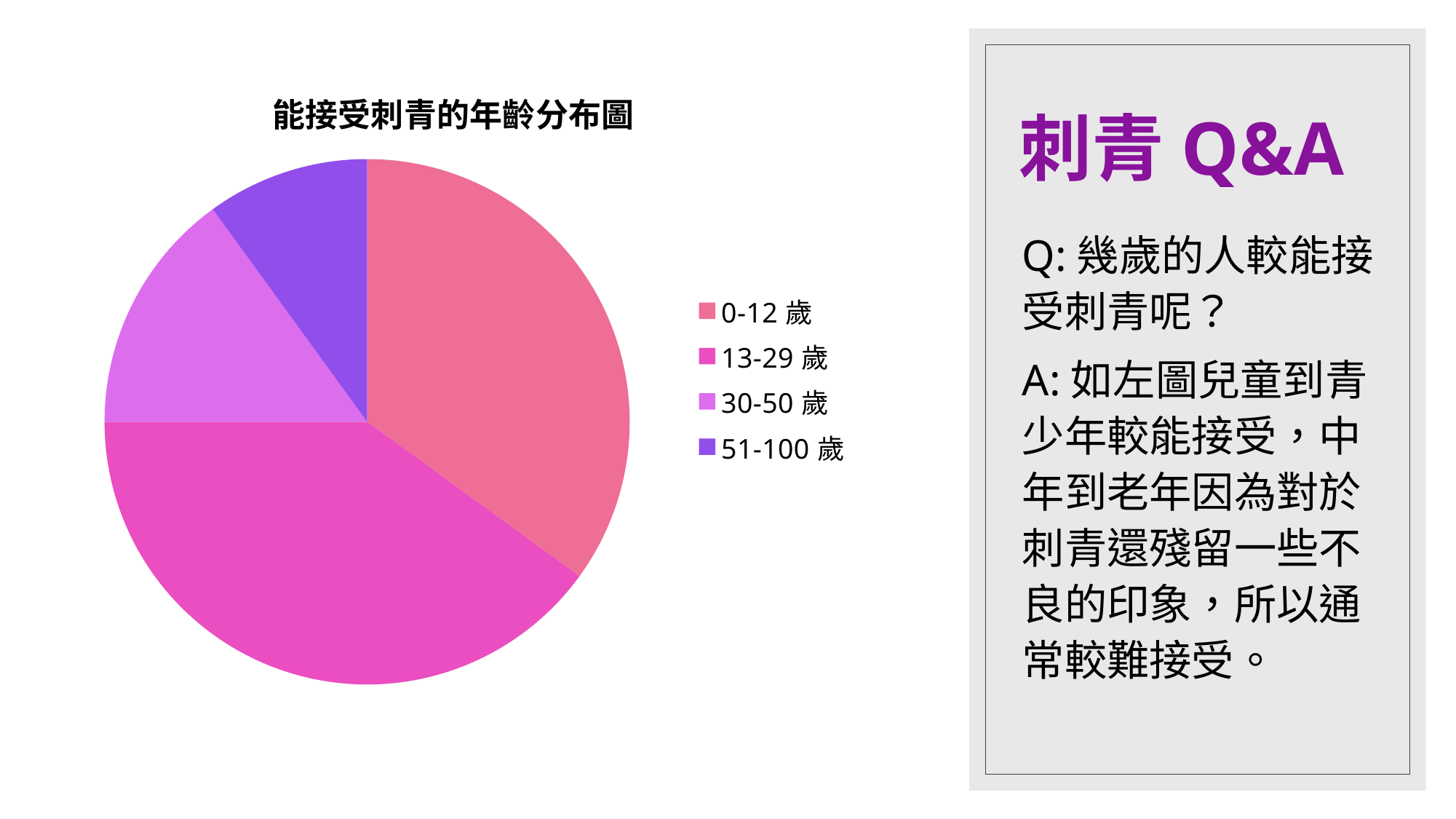
Which slice is larger, 30-50 歲 or 51-100 歲? 30-50 歲 How many age groups (slices) does the pie chart show? 4 Which slice is larger, 0-12 歲 or 30-50 歲? 0-12 歲 What kind of chart is shown on the slide? pie chart Which age group has the largest slice of the pie? 13-29 歲 What is the title of the chart? 能接受刺青的年齡分布圖 Which slice is larger, 13-29 歲 or 0-12 歲? 13-29 歲 Which age group is shown in the darkest purple slice? 51-100 歲 Which age group has the smallest slice of the pie? 51-100 歲